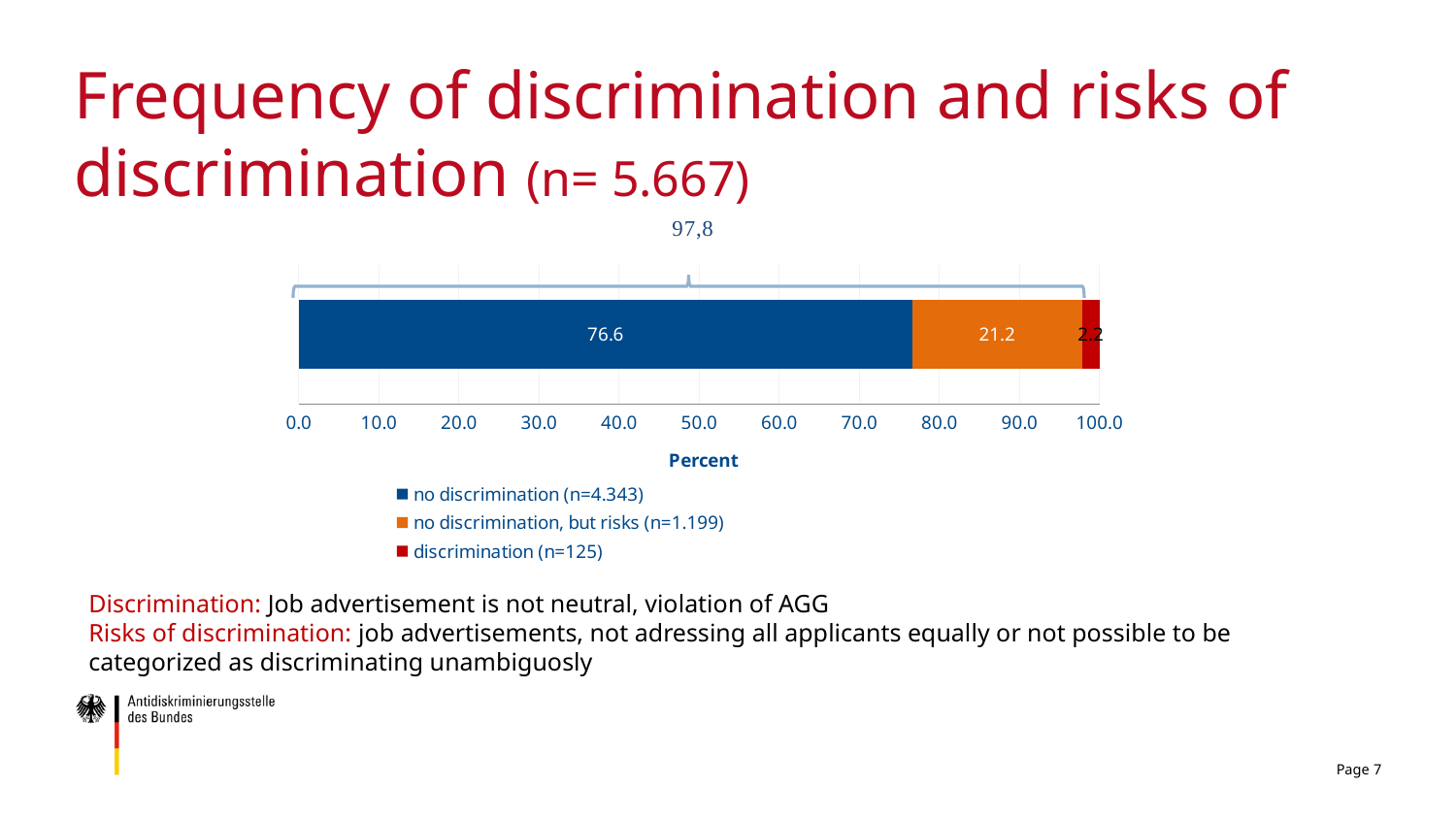
What is the value for "discrimination (n=125)"? 2.2 What is the total of the stacked bar? 100.0 Which series has the largest value? no discrimination (n=4.343) What is the value for "no discrimination (n=4.343)"? 76.6 Which is larger, the value for "no discrimination, but risks" or the value for "discrimination"? no discrimination, but risks What is the difference between the values for "no discrimination" and "no discrimination, but risks"? 55.4 What kind of chart is shown on the slide? stacked bar chart What is the label of the x axis? Percent What value is shown by the bracket label above the bar? 97,8 What is the value for "no discrimination, but risks (n=1.199)"? 21.2 Which series has the smallest value? discrimination (n=125) How many series does the legend list? 3